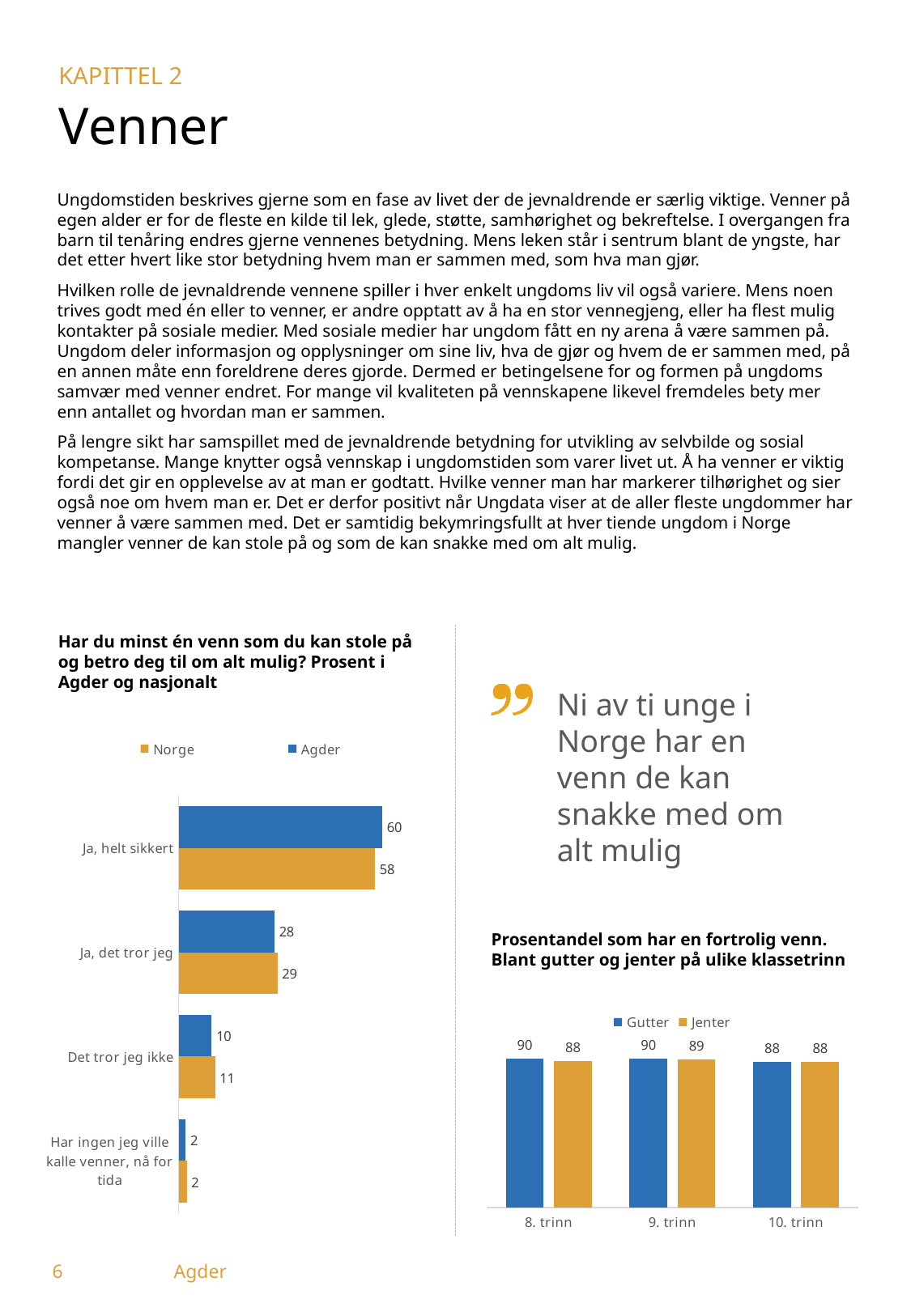
In the right chart (Prosentandel som har en fortrolig venn), what is the value for Jenter in 9. trinn? 89 In the right chart (Prosentandel som har en fortrolig venn), which colour represents Jenter? Orange What kind of chart is the left chart (Har du minst én venn som du kan stole på...)? Bar chart In the left chart (Har du minst én venn som du kan stole på...), what is the value for Agder for 'Ja, helt sikkert'? 60 In the left chart (Har du minst én venn som du kan stole på...), which category has the highest value for Agder? Ja, helt sikkert In the left chart (Har du minst én venn som du kan stole på...), how many series does the legend list? 2 In the left chart (Har du minst én venn som du kan stole på...), how many categories are shown? 4 In the right chart (Prosentandel som har en fortrolig venn), what is the value for Gutter in 10. trinn? 88 In the left chart (Har du minst én venn som du kan stole på...), what is the difference between the Agder and Norge values for 'Ja, helt sikkert'? 2 In the left chart (Har du minst én venn som du kan stole på...), what is the value for Norge for 'Det tror jeg ikke'? 11 In the right chart (Prosentandel som har en fortrolig venn), what is the difference between Gutter and Jenter in 8. trinn? 2 In the left chart (Har du minst én venn som du kan stole på...), what is the value for Norge for 'Ja, det tror jeg'? 29